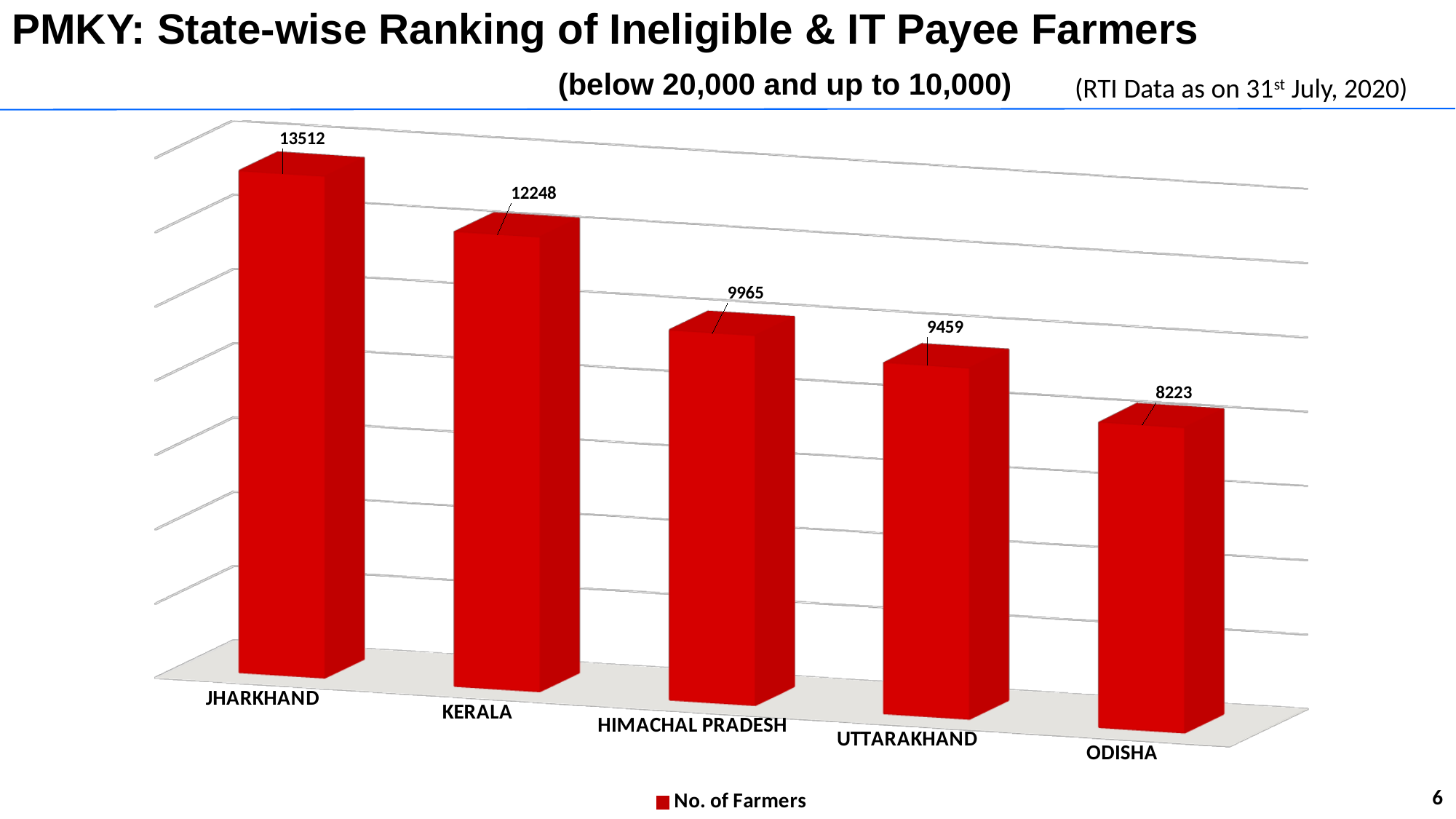
What is the difference in the number of farmers between Jharkhand and Kerala? 1264 What series name does the legend show? No. of Farmers What kind of chart is shown on the slide? Bar chart What is the number of farmers for Himachal Pradesh? 9965 Which state has the highest number of farmers? Jharkhand How many states are shown in the chart? 5 Which state has the lowest number of farmers? Odisha What is the number of farmers for Jharkhand? 13512 What is the number of farmers for Uttarakhand? 9459 What is the number of farmers for Odisha? 8223 What is the number of farmers for Kerala? 12248 Which has more farmers, Himachal Pradesh or Uttarakhand? Himachal Pradesh